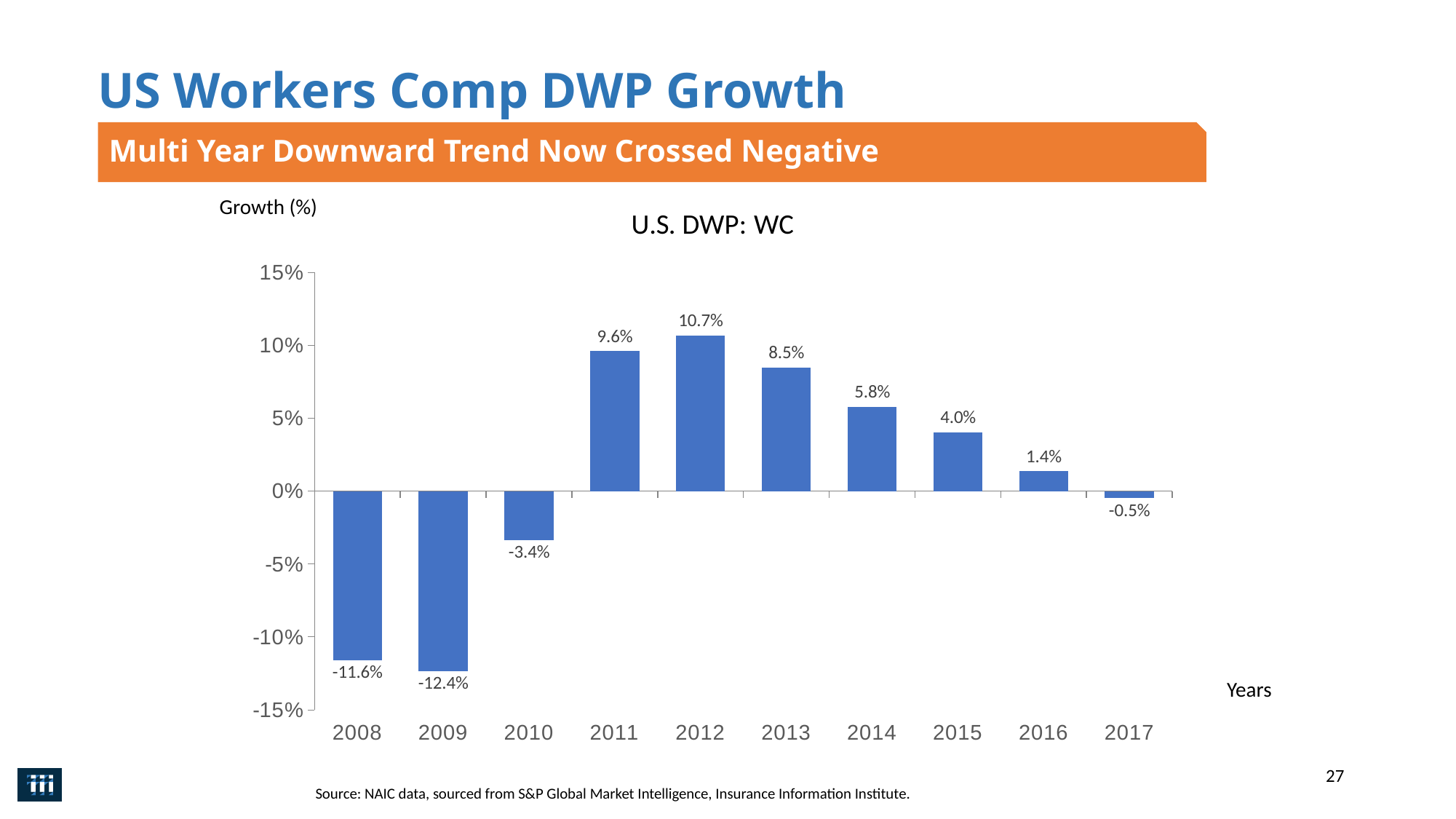
What is the growth value for 2009? -12.4% What is the growth value for 2012? 10.7% Which year has the lowest growth value? 2009 Do the growth values rise or fall from 2012 to 2017? Fall How many years are shown on the x axis? 10 Which year has the highest growth value? 2012 Which year has the larger growth value, 2014 or 2015? 2014 What is the growth value for 2017? -0.5% What is the title of the chart? U.S. DWP: WC Is the value for 2010 greater or less than -5%? greater What is the difference between the growth values for 2011 and 2013? 1.1% What kind of chart is shown on the slide? Bar chart